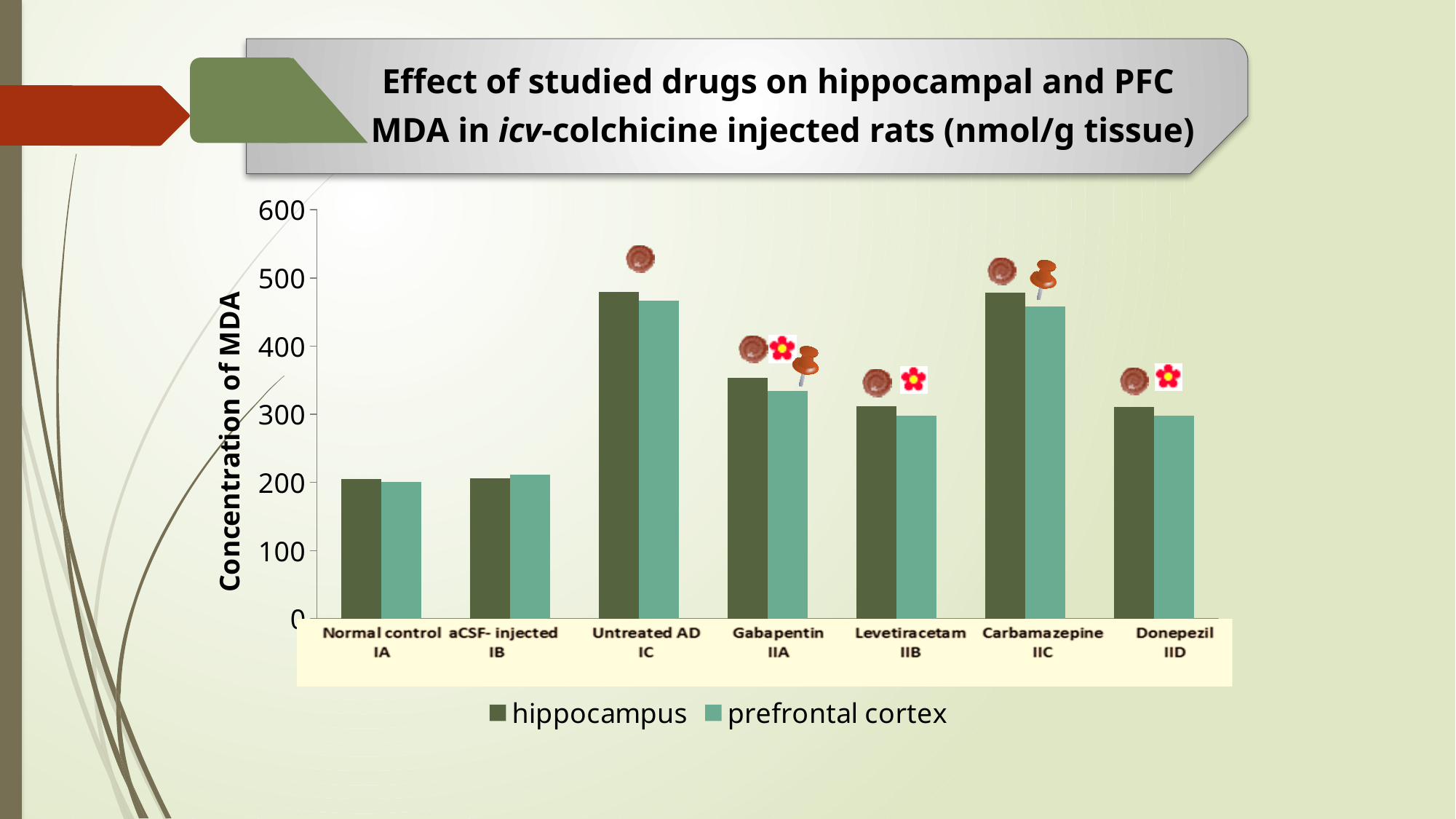
Is the hippocampus value for Untreated AD IC greater or less than 400? greater What are the two series named in the legend? hippocampus and prefrontal cortex Which has the larger hippocampus value, Untreated AD IC or Gabapentin IIA? Untreated AD IC What kind of chart is shown on the slide? bar chart Which has the larger prefrontal cortex value, Carbamazepine IIC or Levetiracetam IIB? Carbamazepine IIC What is the label of the vertical axis? Concentration of MDA How many series does the legend list? 2 Is the hippocampus value for Gabapentin IIA greater or less than 400? less Is the prefrontal cortex value for Carbamazepine IIC greater or less than 400? greater How many treatment groups (categories) are shown on the x axis? 7